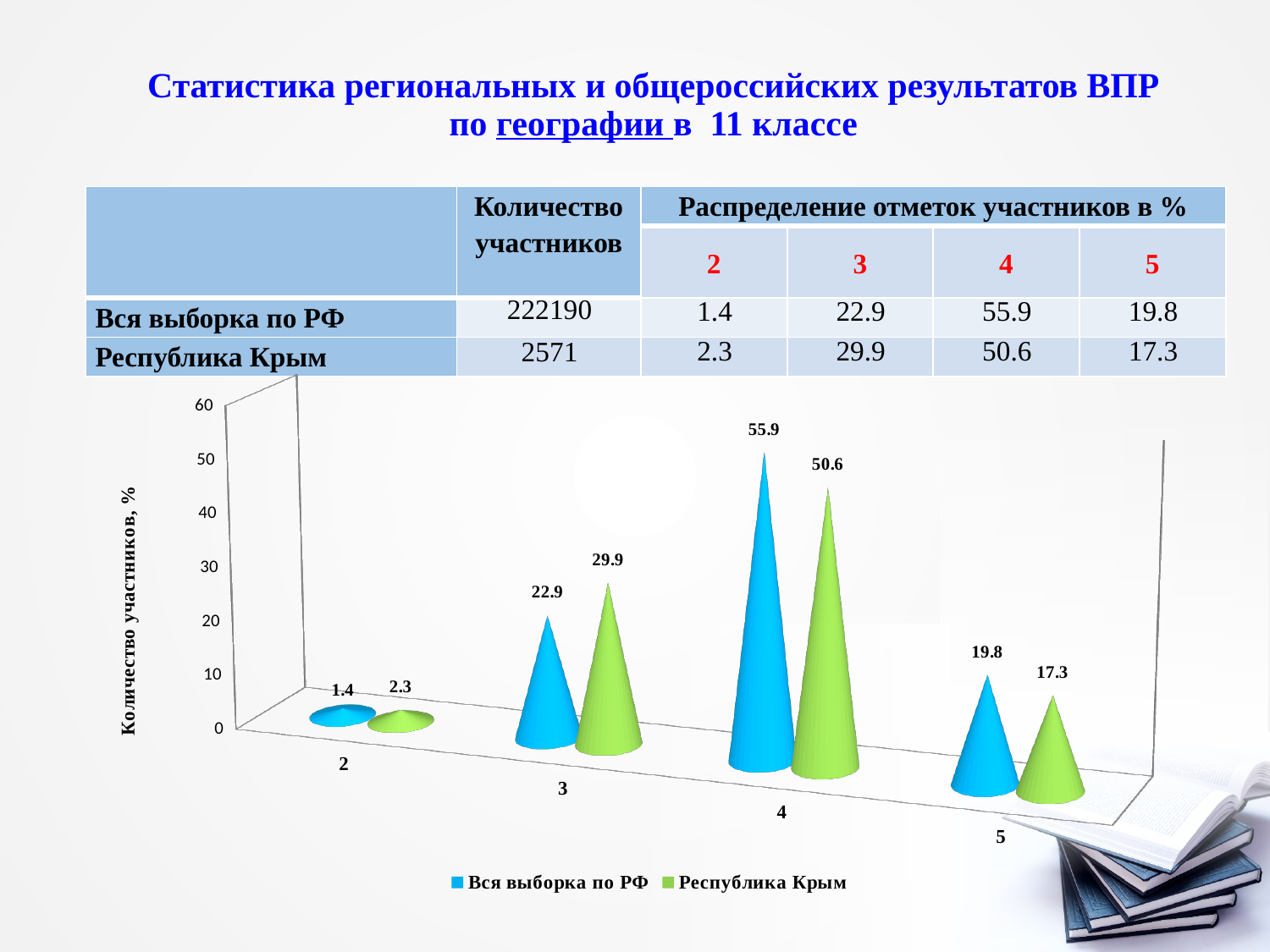
How many series does the chart legend list? 2 How many grade categories are shown on the x axis of the chart? 4 What is the value for grade 4 in the "Вся выборка по РФ" series? 55.9 Is the value for grade 5 in the "Вся выборка по РФ" series greater or less than 10? greater What is the label of the vertical axis of the chart? Количество участников, % For grade 3, which series has the larger value: "Вся выборка по РФ" or "Республика Крым"? Республика Крым Which grade category has the lowest value for "Вся выборка по РФ"? 2 Which grade category has the highest value for "Республика Крым"? 4 What is the value for grade 5 in the "Республика Крым" series? 17.3 What is the value for grade 2 in the "Вся выборка по РФ" series? 1.4 What is the value for grade 3 in the "Республика Крым" series? 29.9 What is the difference between the "Вся выборка по РФ" and "Республика Крым" values for grade 4? 5.3